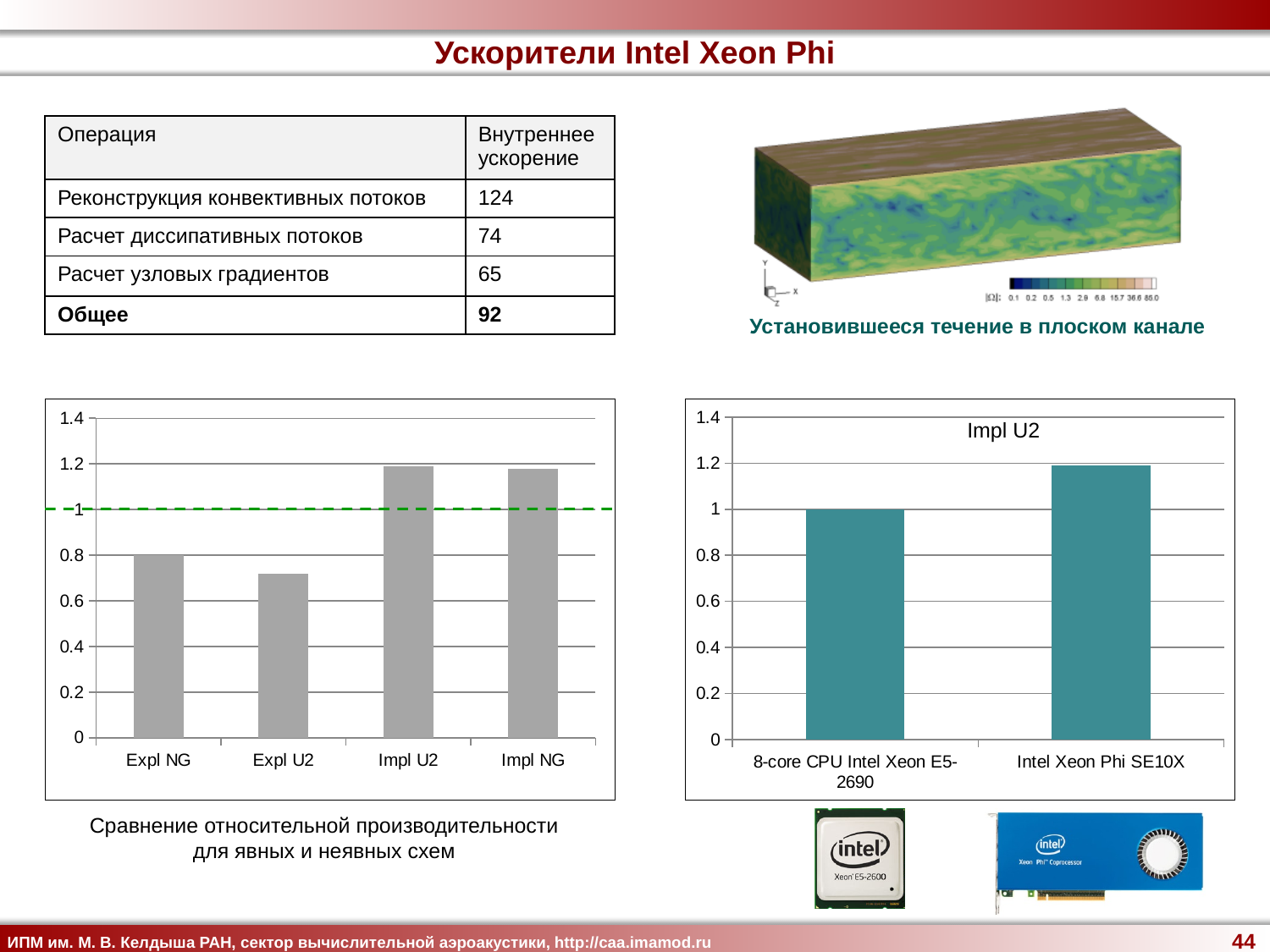
At what level is the green dashed horizontal line drawn in the left chart? 1 In the left chart, is the value for Impl U2 greater or less than 1? greater What kind of chart is the chart on the left of the slide (with categories Expl NG, Expl U2, Impl U2, Impl NG)? bar chart What is the title of the chart on the right of the slide? Impl U2 In the left chart, which is larger: the value for Impl NG or the value for Expl U2? Impl NG How many categories are shown on the x axis of the left chart? 4 How many bars are shown in the right chart titled Impl U2? 2 In the right chart titled Impl U2, which category has the highest bar? Intel Xeon Phi SE10X In the right chart titled Impl U2, what is the value for 8-core CPU Intel Xeon E5-2690? 1 In the left chart, which category has the lowest bar? Expl U2 In the left chart, is the value for Expl NG greater or less than 1? less In the left chart, which is larger: the value for Expl NG or the value for Expl U2? Expl NG